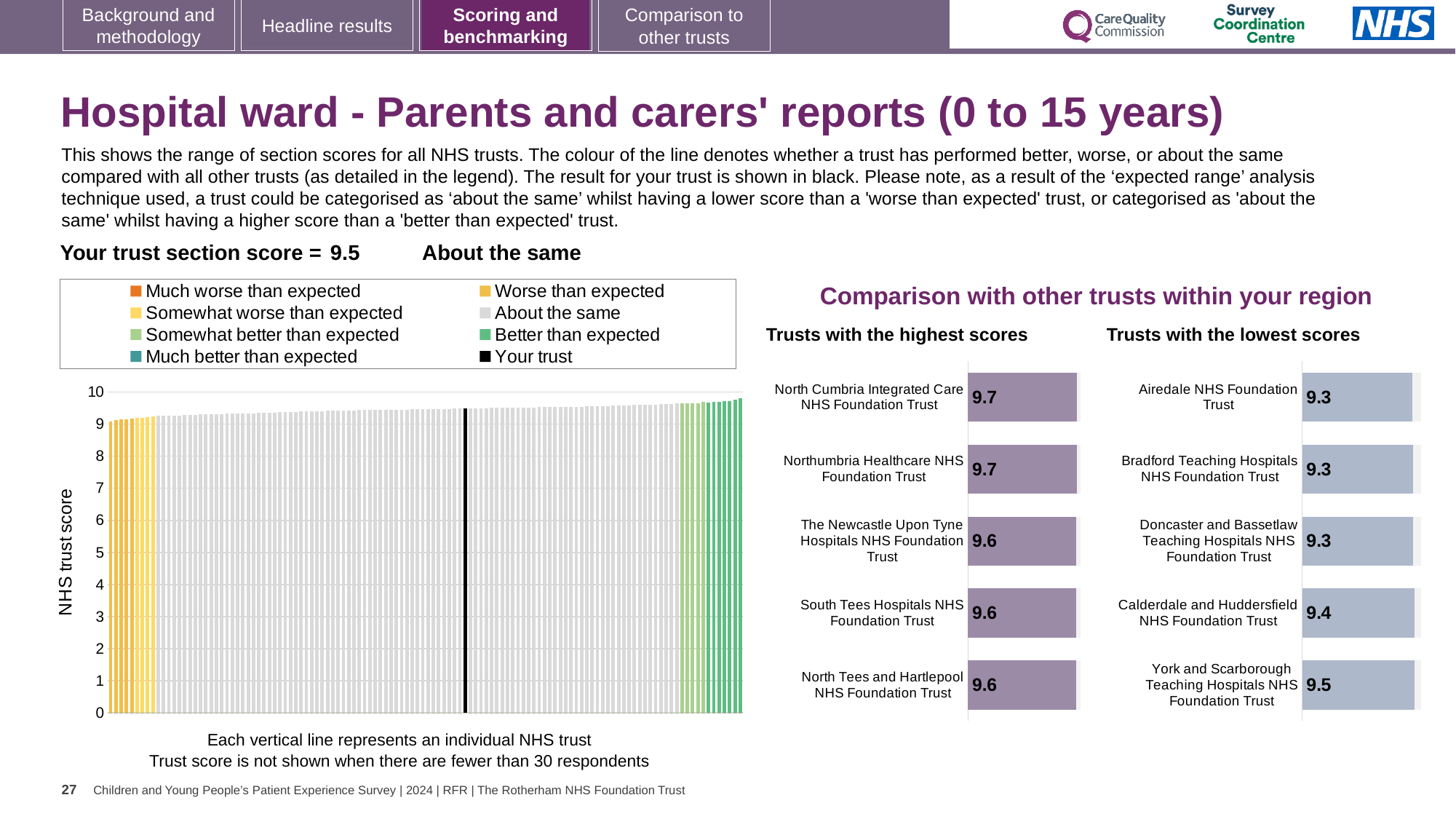
What kind of chart is the large chart on the left showing NHS trust scores? Bar chart In the 'Trusts with the lowest scores' chart, what is the difference between the score for York and Scarborough Teaching Hospitals NHS Foundation Trust and the score for Airedale NHS Foundation Trust? 0.2 In the 'Trusts with the lowest scores' chart, what is the score for Calderdale and Huddersfield NHS Foundation Trust? 9.4 In the 'Trusts with the lowest scores' chart, which trust has the highest score? York and Scarborough Teaching Hospitals NHS Foundation Trust How many entries does the legend of the left-hand chart list? 8 What is the section score for your trust shown on the slide? 9.5 In the 'Trusts with the highest scores' chart, what is the difference between the score for North Cumbria Integrated Care NHS Foundation Trust and the score for North Tees and Hartlepool NHS Foundation Trust? 0.1 In the 'Trusts with the highest scores' chart, what is the score for South Tees Hospitals NHS Foundation Trust? 9.6 In the 'Trusts with the lowest scores' chart, which has the larger score: Calderdale and Huddersfield NHS Foundation Trust or York and Scarborough Teaching Hospitals NHS Foundation Trust? York and Scarborough Teaching Hospitals NHS Foundation Trust In the 'Trusts with the highest scores' chart, what is the score for North Cumbria Integrated Care NHS Foundation Trust? 9.7 In the 'Trusts with the lowest scores' chart, what is the score for York and Scarborough Teaching Hospitals NHS Foundation Trust? 9.5 How many trusts are listed in the 'Trusts with the highest scores' chart? 5